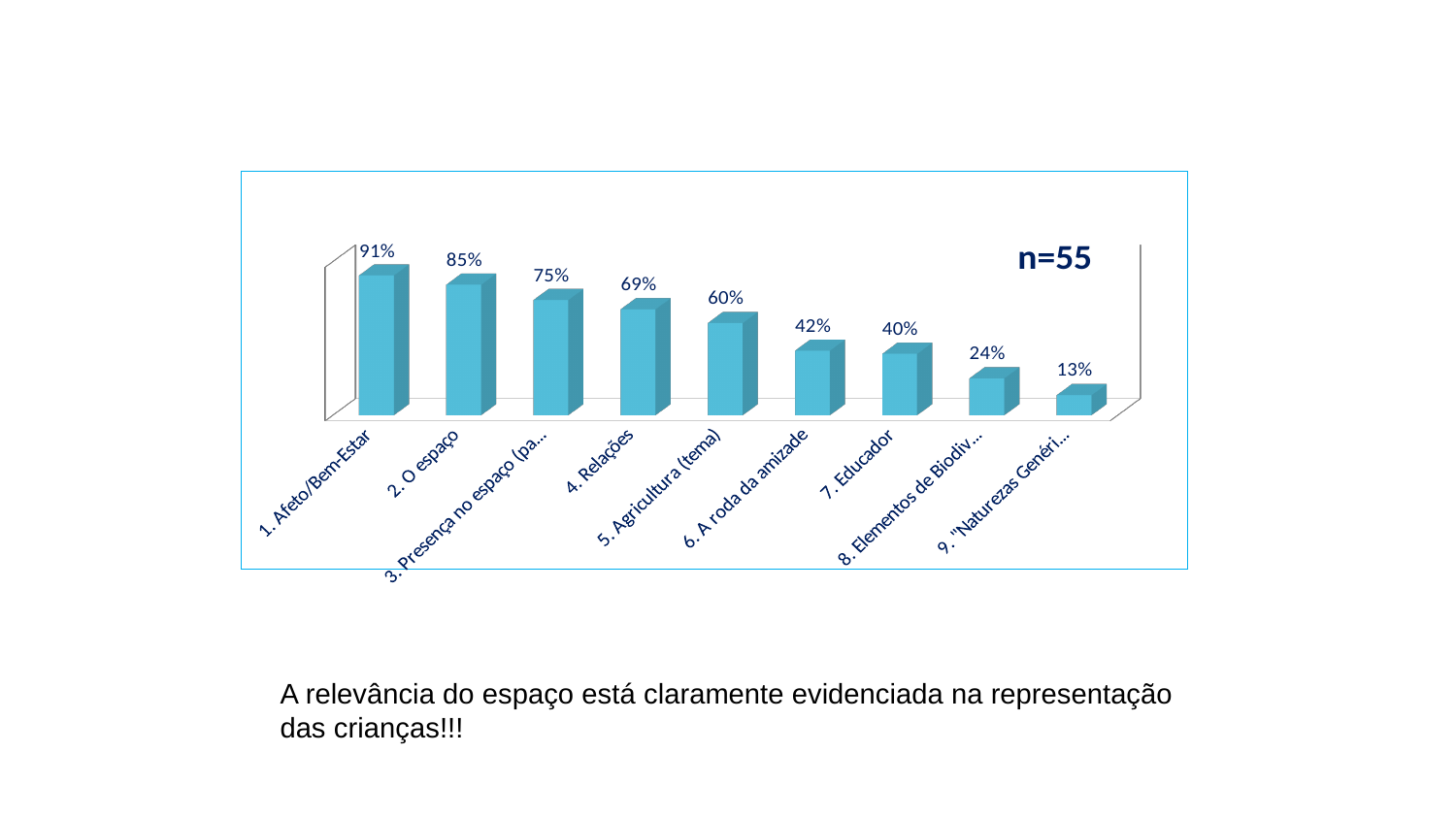
What sample size is annotated on the chart? n=55 Which is larger, the value for 4. Relações or the value for 7. Educador? 4. Relações What is the value for 1. Afeto/Bem-Estar? 91% Which category has the lowest value? 9. "Naturezas Genéri..." What is the value for 7. Educador? 40% What kind of chart is shown on the slide? Bar chart How many categories are shown in the chart? 9 What is the difference between the values for 2. O espaço and 6. A roda da amizade? 43% Do the values rise or fall from left to right along the x axis? Fall Which category has the highest value? 1. Afeto/Bem-Estar What is the value for 4. Relações? 69% What is the value for 5. Agricultura (tema)? 60%